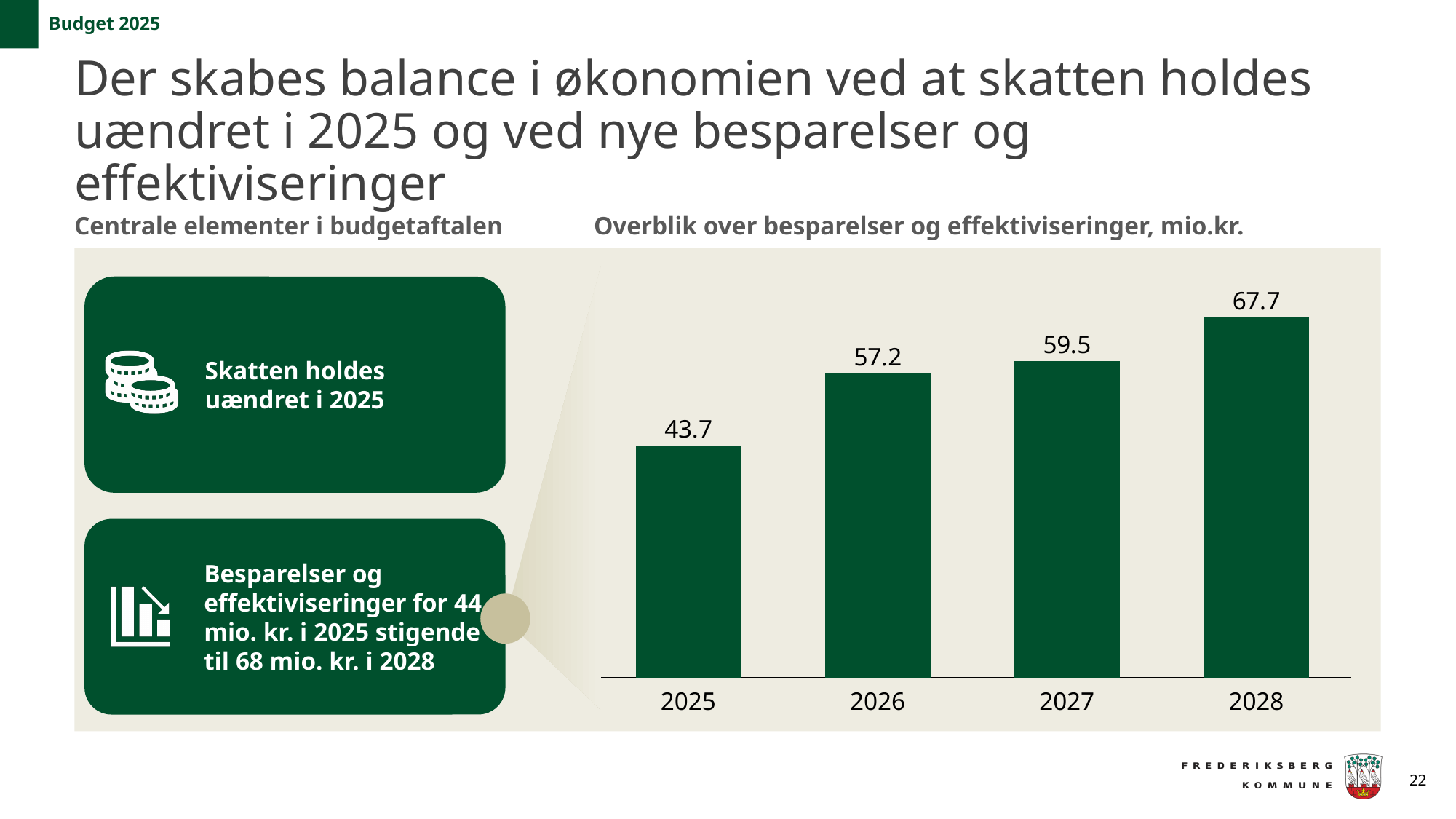
What is the value for 2026? 57.2 Do the values rise or fall from 2025 to 2028? Rise How many years are shown on the x axis? 4 What is the value for 2028? 67.7 Which year has the lowest value? 2025 Which is larger, the value for 2027 or the value for 2026? 2027 What kind of chart is shown? Bar chart What is the value for 2027? 59.5 What is the difference between the values for 2028 and 2025? 24.0 What is the value for 2025? 43.7 What is the difference between the values for 2026 and 2025? 13.5 Which year has the highest value? 2028